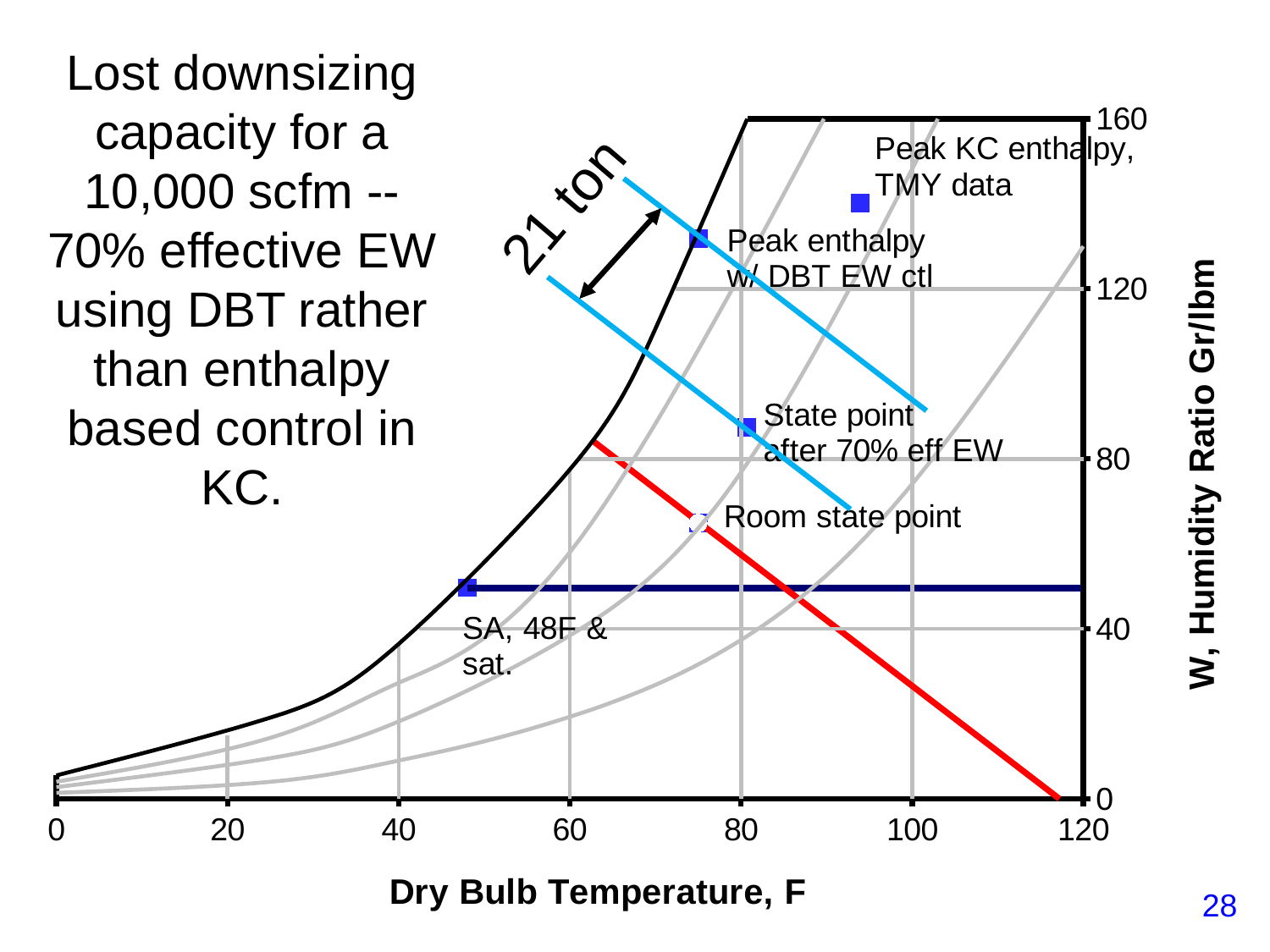
What dry bulb temperature is given in the label for the SA (supply air) point? 48F Which labeled state point has the lowest dry bulb temperature? SA, 48F & sat. Is the humidity ratio of the 'Room state point' greater or less than 80? less What is the title of the y axis of the chart? W, Humidity Ratio Gr/lbm Is the humidity ratio of the 'Peak KC enthalpy, TMY data' point greater or less than 120? greater Is the humidity ratio of the 'SA, 48F & sat.' point greater or less than 40? greater What is the title of the x axis of the chart? Dry Bulb Temperature, F What capacity value is written next to the double-headed arrow between the two blue lines? 21 ton Which point has the higher humidity ratio, 'Peak KC enthalpy, TMY data' or 'Room state point'? Peak KC enthalpy, TMY data